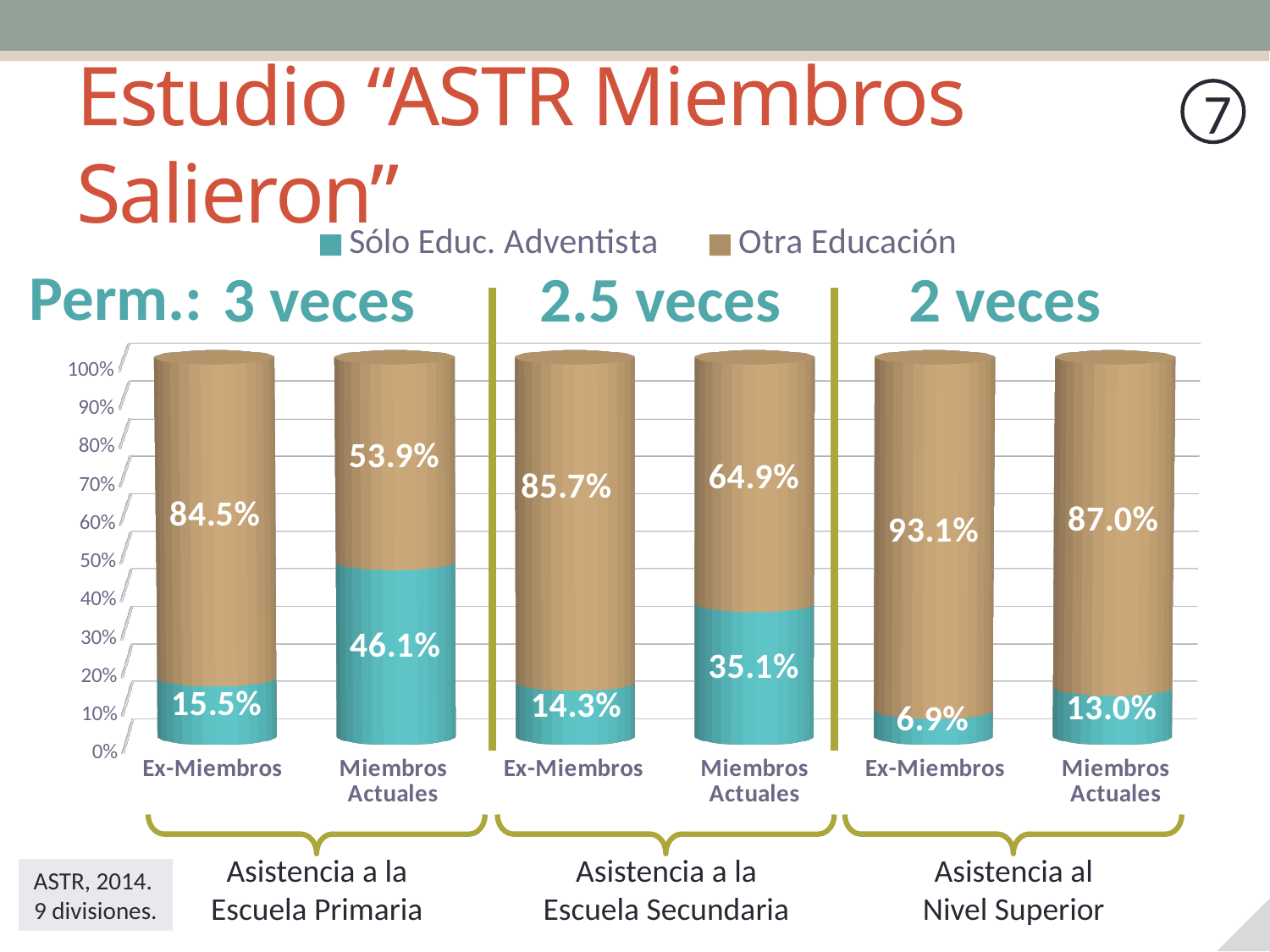
How many series does the legend list? 2 Which colour represents "Otra Educación" in the chart? Tan (brown) Which bar has the highest "Sólo Educ. Adventista" value? Miembros Actuales (Asistencia a la Escuela Primaria) What is the value of "Otra Educación" for Miembros Actuales in the Asistencia al Nivel Superior group? 87.0% What is the difference between the "Sólo Educ. Adventista" values for Miembros Actuales and Ex-Miembros in the Asistencia a la Escuela Secundaria group? 20.8% What kind of chart is shown on the slide? Stacked bar chart What is the value of "Otra Educación" for Ex-Miembros in the Asistencia a la Escuela Secundaria group? 85.7% Which bar has the lowest "Sólo Educ. Adventista" value? Ex-Miembros (Asistencia al Nivel Superior) How many bars are plotted in the chart? 6 What is the value of "Sólo Educ. Adventista" for Ex-Miembros in the Asistencia al Nivel Superior group? 6.9% What is the value of "Sólo Educ. Adventista" for Miembros Actuales in the Asistencia a la Escuela Primaria group? 46.1% Which is larger: the "Sólo Educ. Adventista" value for Ex-Miembros in the Escuela Primaria group or for Ex-Miembros in the Escuela Secundaria group? Ex-Miembros in the Escuela Primaria group